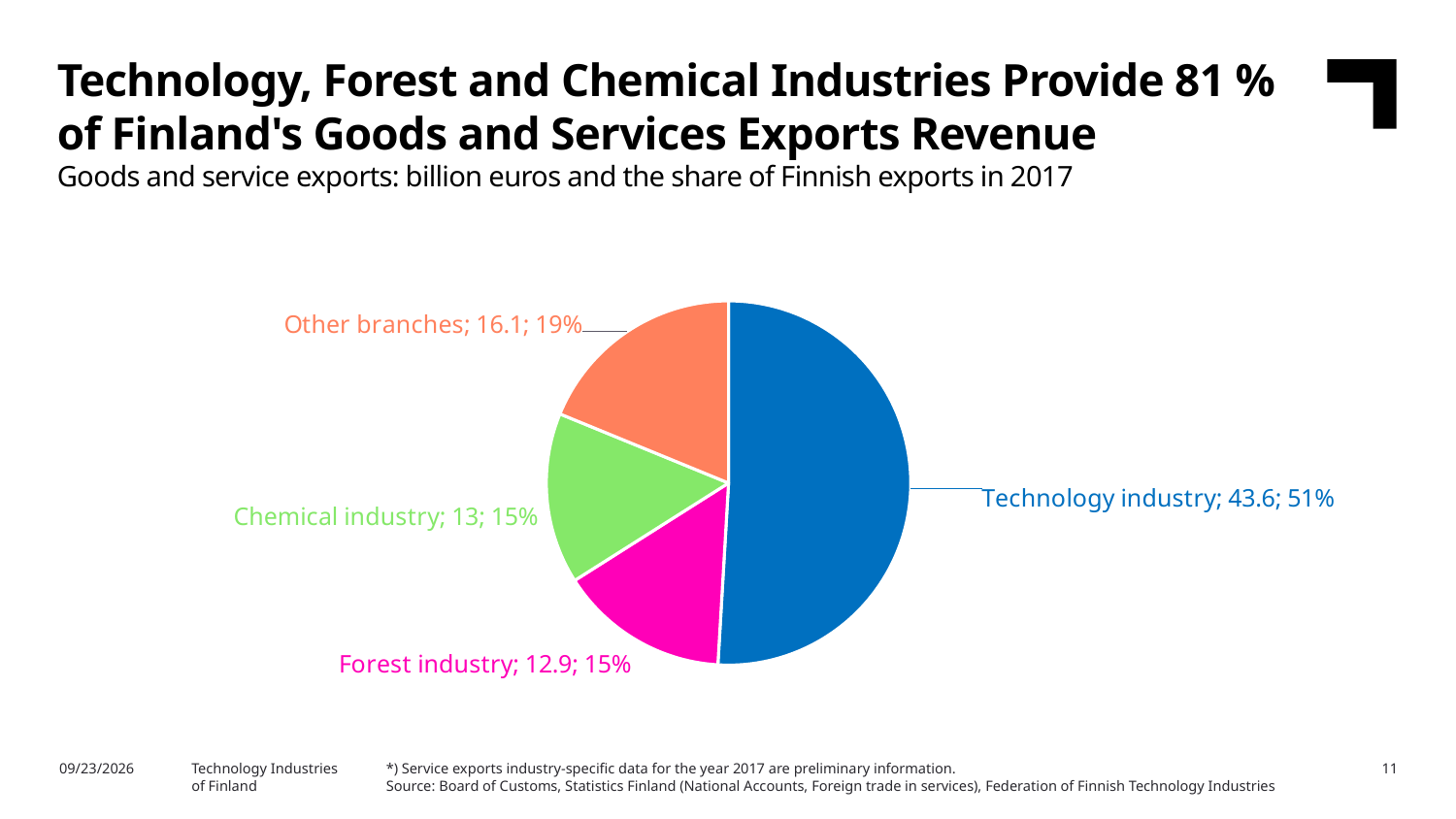
How many slices does the pie chart have? 4 Which is larger, the export value for the Technology industry or for Other branches? Technology industry Which slice of the pie chart is the largest? Technology industry What is the export value in billion euros for Other branches? 16.1 What colour is the Forest industry slice in the pie chart? magenta What is the difference in billion euros between Other branches and the Chemical industry? 3.1 What is the export value in billion euros for the Chemical industry? 13 What is the difference in billion euros between the Technology industry and Other branches? 27.5 What type of chart is shown on the slide? pie chart What is the export value in billion euros for the Technology industry? 43.6 What share of Finnish exports does the Forest industry account for? 15% What share of Finnish exports does the Technology industry account for? 51%